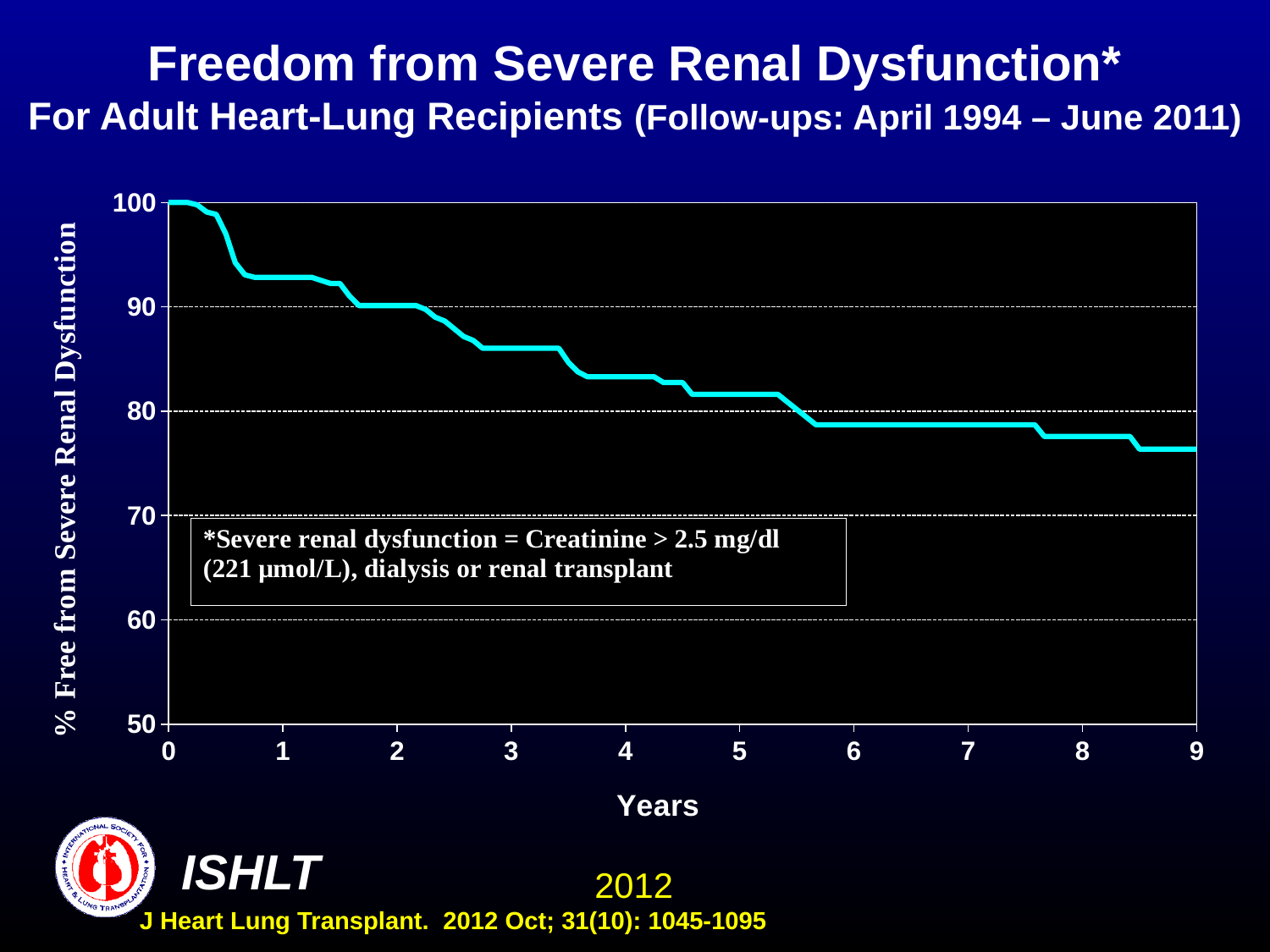
Is the value at year 3 greater or less than 90? less Is the value at year 9 greater or less than 80? less How many lines (series) are plotted on the chart? 1 Is the value at year 8 greater or less than 80? less What is the label of the x axis? Years Which is larger, the value at year 2 or the value at year 6? Year 2 What is the % free from severe renal dysfunction at year 0? 100 Does the % free from severe renal dysfunction rise or fall as years increase? Fall What kind of chart is shown on the slide? Line chart What is the label of the y axis? % Free from Severe Renal Dysfunction